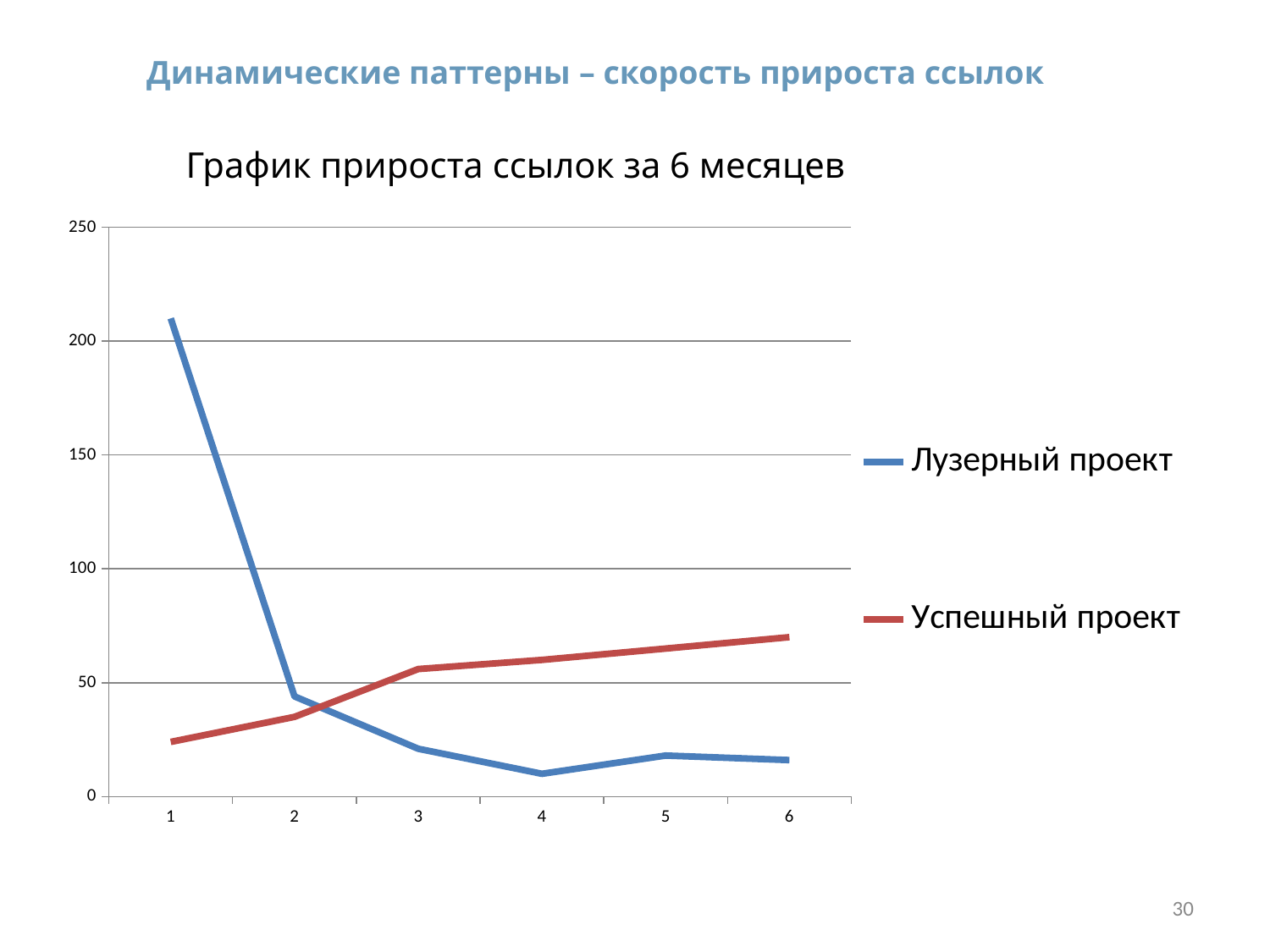
At which month is the value for Лузерный проект lowest? 4 At month 1, which series has the larger value, Лузерный проект or Успешный проект? Лузерный проект How many series does the legend list? 2 What kind of chart is shown on the slide? line chart Is the value for Лузерный проект at month 1 greater or less than 200? greater Do the values for Успешный проект rise or fall from month 1 to month 6? rise At which month is the value for Успешный проект highest? 6 Is the value for Успешный проект at month 6 greater or less than 100? less At which month is the value for Лузерный проект highest? 1 Is the value for Лузерный проект at month 4 greater or less than 50? less What is the title of the chart? График прироста ссылок за 6 месяцев How many points are plotted along the x axis for each series? 6